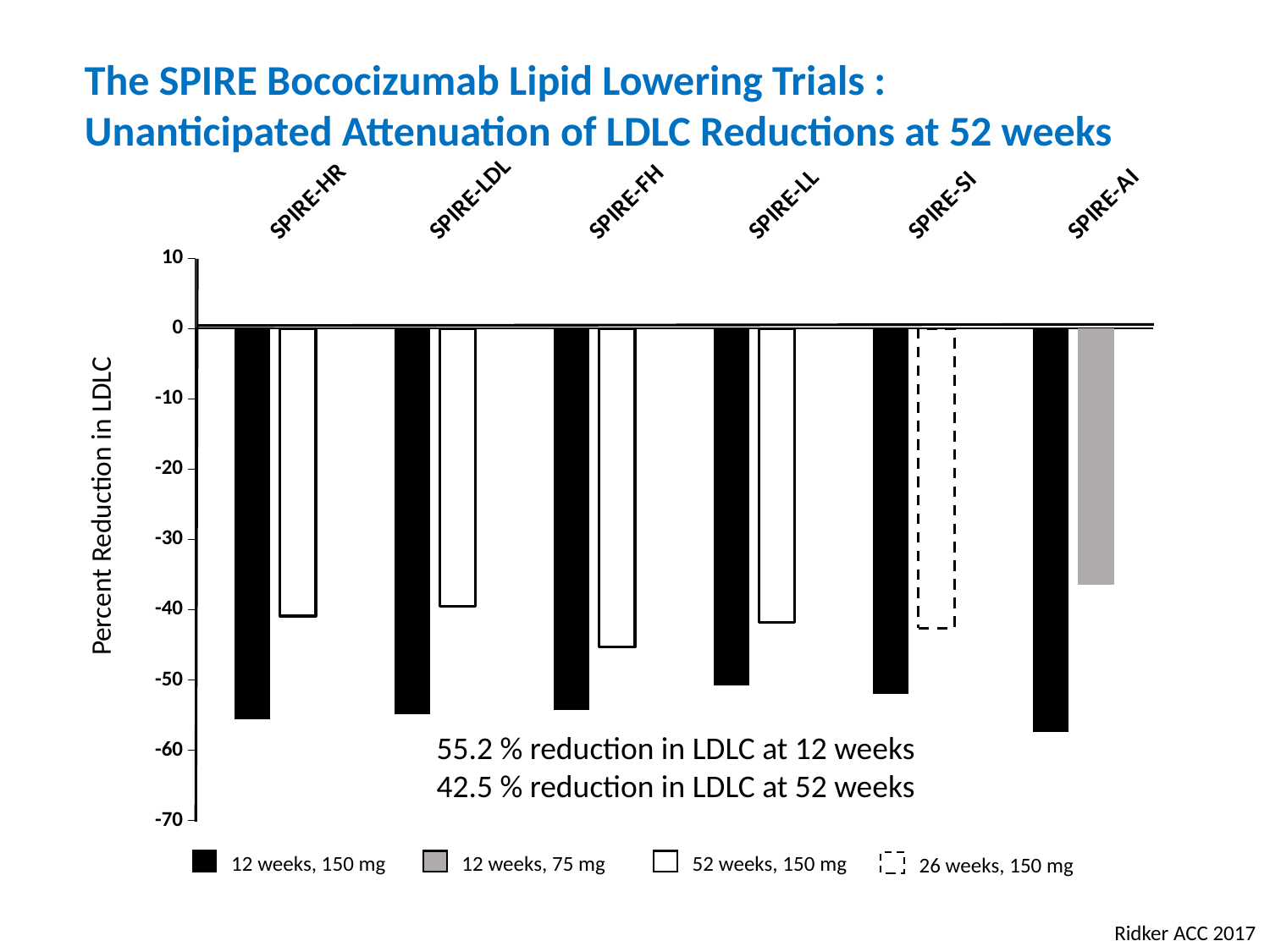
Is the value of the 12 weeks, 75 mg bar for SPIRE-AI greater or less than -40? greater What percent reduction in LDLC at 52 weeks is stated in the text on the chart? 42.5 % Which trial shows the larger percent reduction in LDLC at 12 weeks with 150 mg, SPIRE-AI or SPIRE-LL? SPIRE-AI Is the value of the 52 weeks, 150 mg bar for SPIRE-FH greater or less than -40? less How many SPIRE trials are shown along the x axis of the chart? 6 Is the value of the 26 weeks, 150 mg bar for SPIRE-SI greater or less than -40? less What kind of chart is shown on the slide? Bar chart Which trial is the only one with a dashed-outline bar (26 weeks, 150 mg)? SPIRE-SI What is the label of the chart's y axis? Percent Reduction in LDLC How many series does the chart's legend list? 4